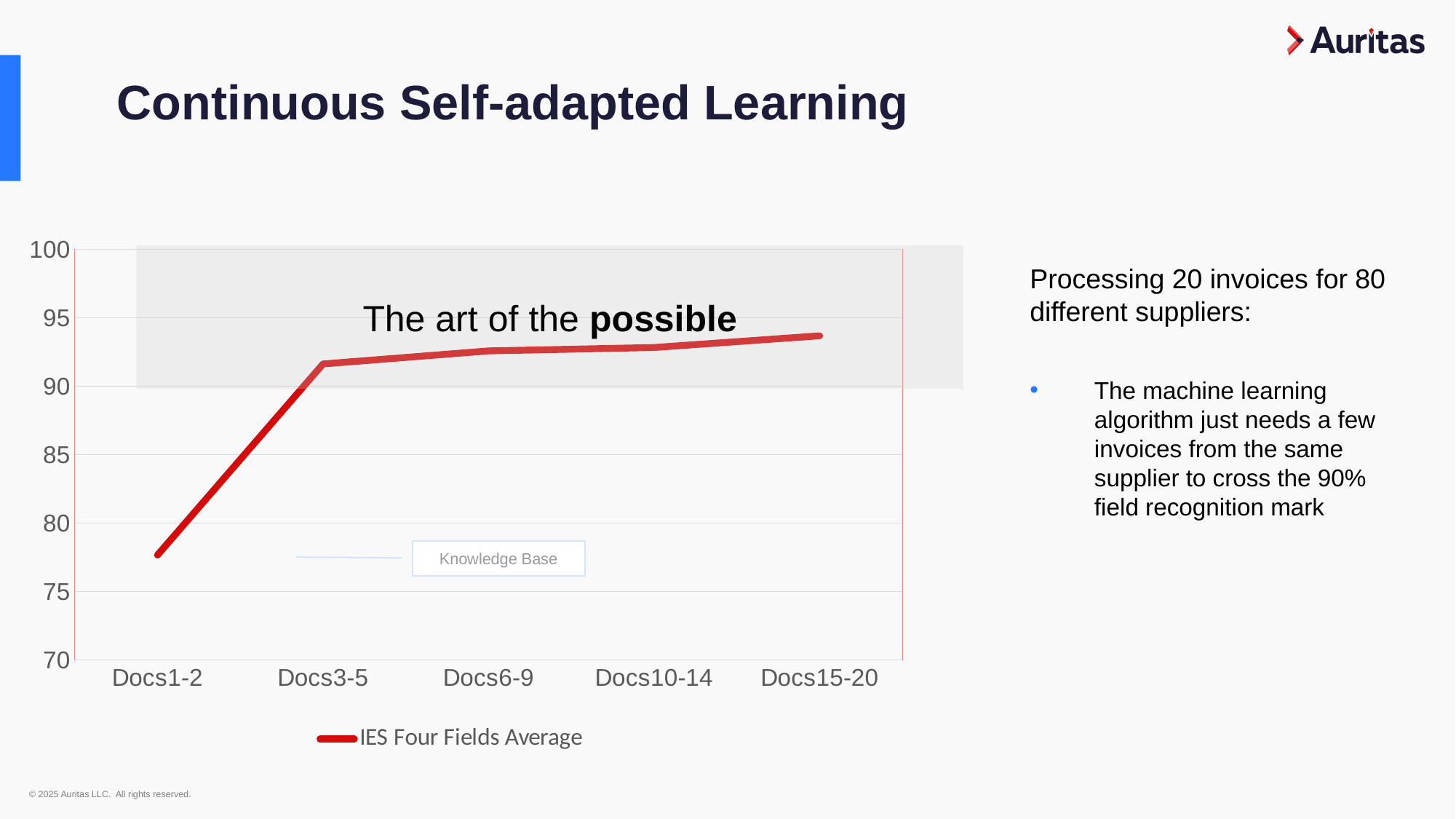
Is the value for Docs1-2 greater or less than 80? less How many series does the chart legend list? 1 What kind of chart is shown on the slide? line chart Which is larger, the value for Docs1-2 or the value for Docs3-5? Docs3-5 Which category has the lowest value for IES Four Fields Average? Docs1-2 Is the value for Docs15-20 greater or less than 95? less Do the values of IES Four Fields Average rise or fall from Docs1-2 to Docs15-20? rise What text annotation is printed inside the shaded band at the top of the chart? The art of the possible Is the value for Docs3-5 greater or less than 90? greater How many categories are shown on the x axis of the chart? 5 What is the name of the series shown in the chart legend? IES Four Fields Average